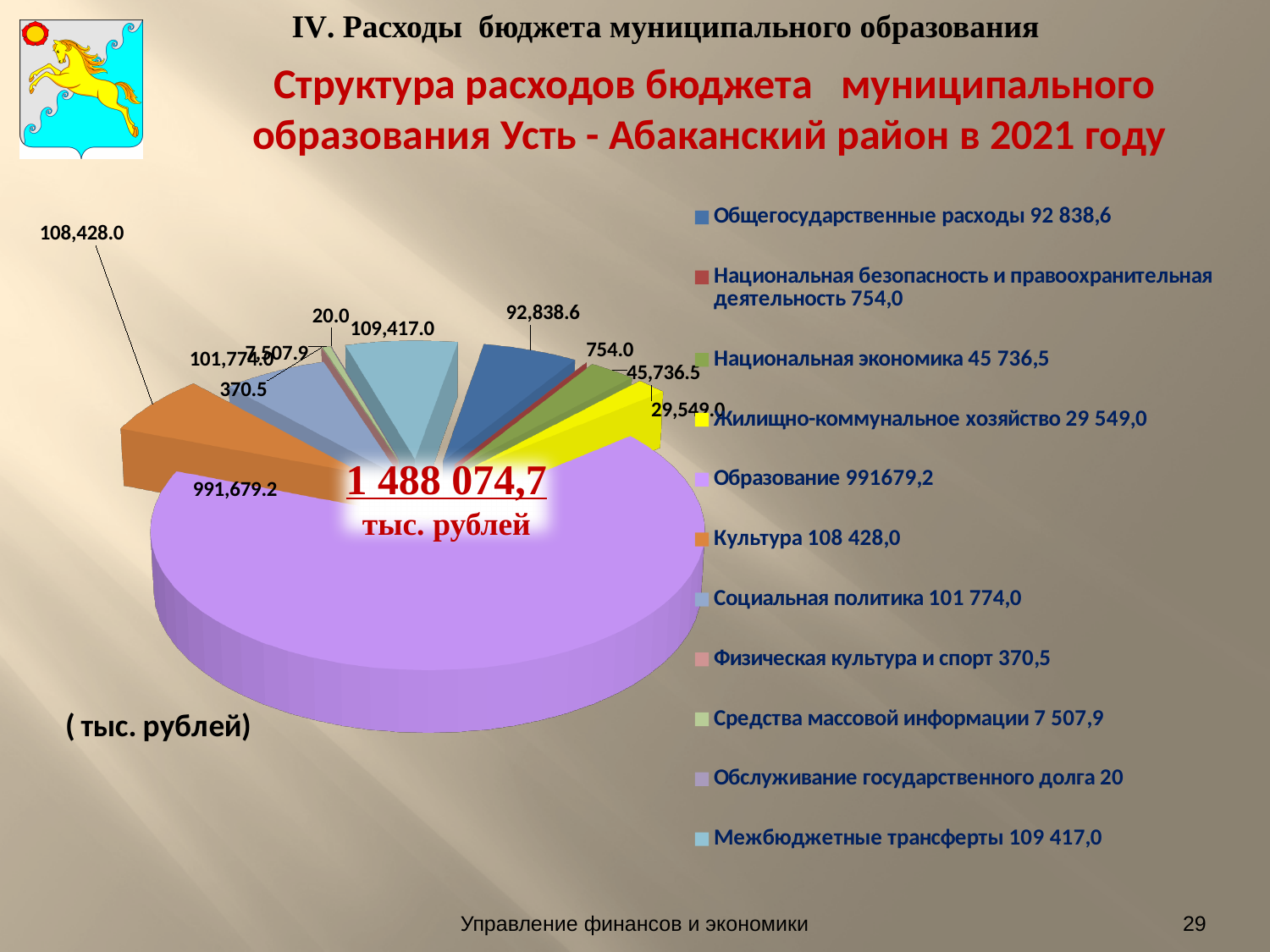
How many expenditure categories does the pie chart show? 11 What colour is the Образование slice of the pie chart? Purple (lilac) By how much does Межбюджетные трансферты exceed Культура, according to the data labels? 989.0 Which expenditure category has the smallest value in the pie chart? Обслуживание государственного долга What is the data label value for Культура in the pie chart? 108,428.0 Which is larger: Общегосударственные расходы or Национальная экономика? Общегосударственные расходы What is the data label value for Жилищно-коммунальное хозяйство in the pie chart? 29,549.0 What type of chart is shown on the slide? Pie chart Which expenditure category has the largest slice of the pie? Образование What is the data label value for Межбюджетные трансферты in the pie chart? 109,417.0 What total value is printed in the centre of the pie chart? 1 488 074,7 тыс. рублей What is the difference between Национальная экономика and Жилищно-коммунальное хозяйство, according to the data labels? 16,187.5